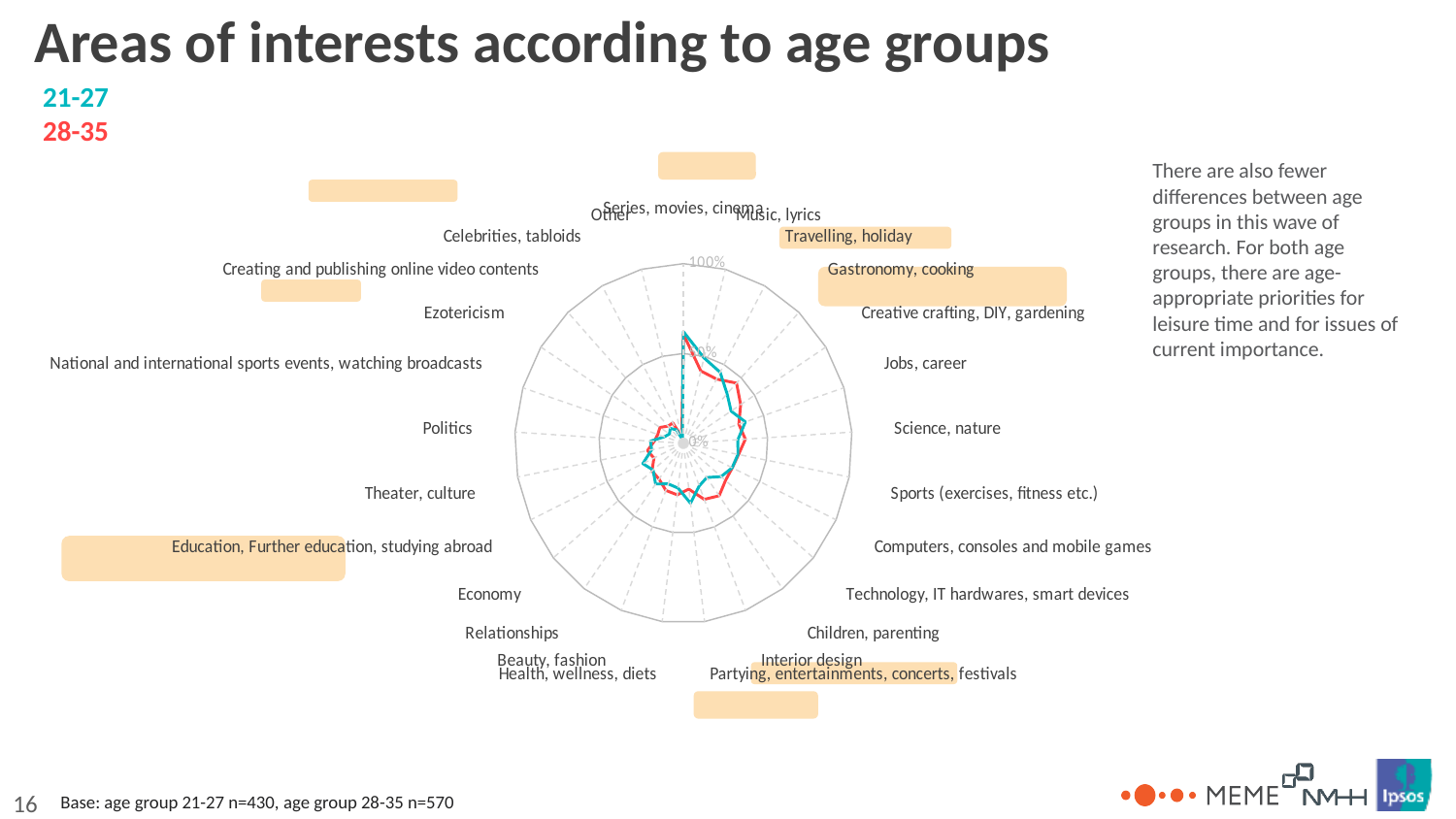
Is the value for Economy for the 28-35 age group greater or less than 50%? less Is the value for Politics for the 21-27 age group greater or less than 50%? less Which area of interest has the highest value for both age groups? Series, movies, cinema Which age groups are compared in the chart? 21-27 and 28-35 What kind of chart is shown on the slide? Radar chart Is the value for Ezotericism for the 28-35 age group greater or less than 50%? less What is the maximum value shown on the chart's radial axis? 100% How many age-group series are plotted on the chart? 2 What is the title of the slide's chart? Areas of interests according to age groups